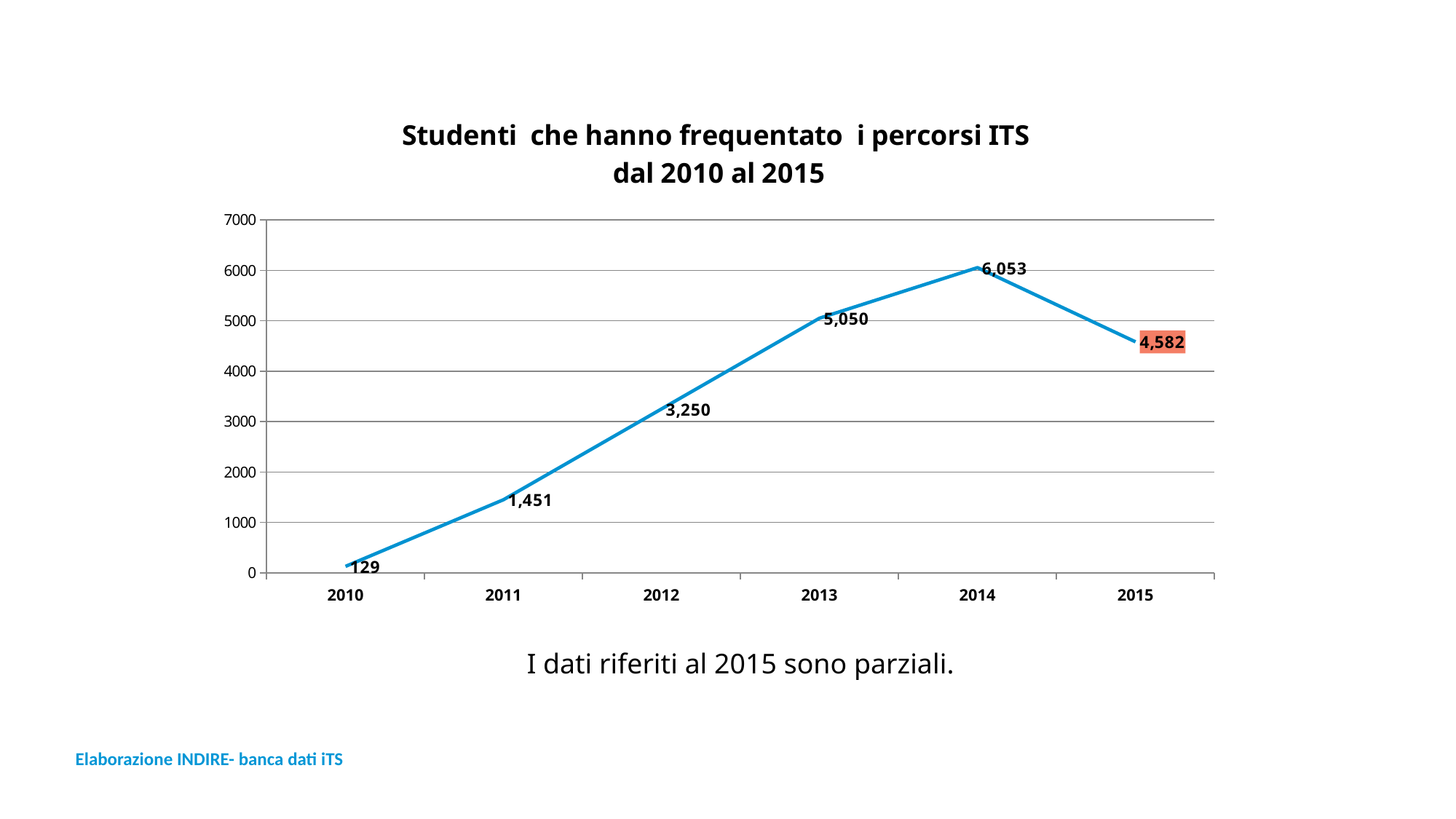
Which year has the highest value? 2014 What is the value for 2010? 129 How many years are plotted on the chart? 6 What is the value for 2012? 3,250 What kind of chart is shown on the slide? line chart Which year has the lowest value? 2010 Which is larger, the value for 2013 or the value for 2015? 2013 What is the difference between the values for 2013 and 2012? 1,800 What is the difference between the values for 2014 and 2015? 1,471 Do the values rise or fall from 2010 to 2014? rise What is the value for 2015? 4,582 Is the value for 2011 greater or less than 2000? less